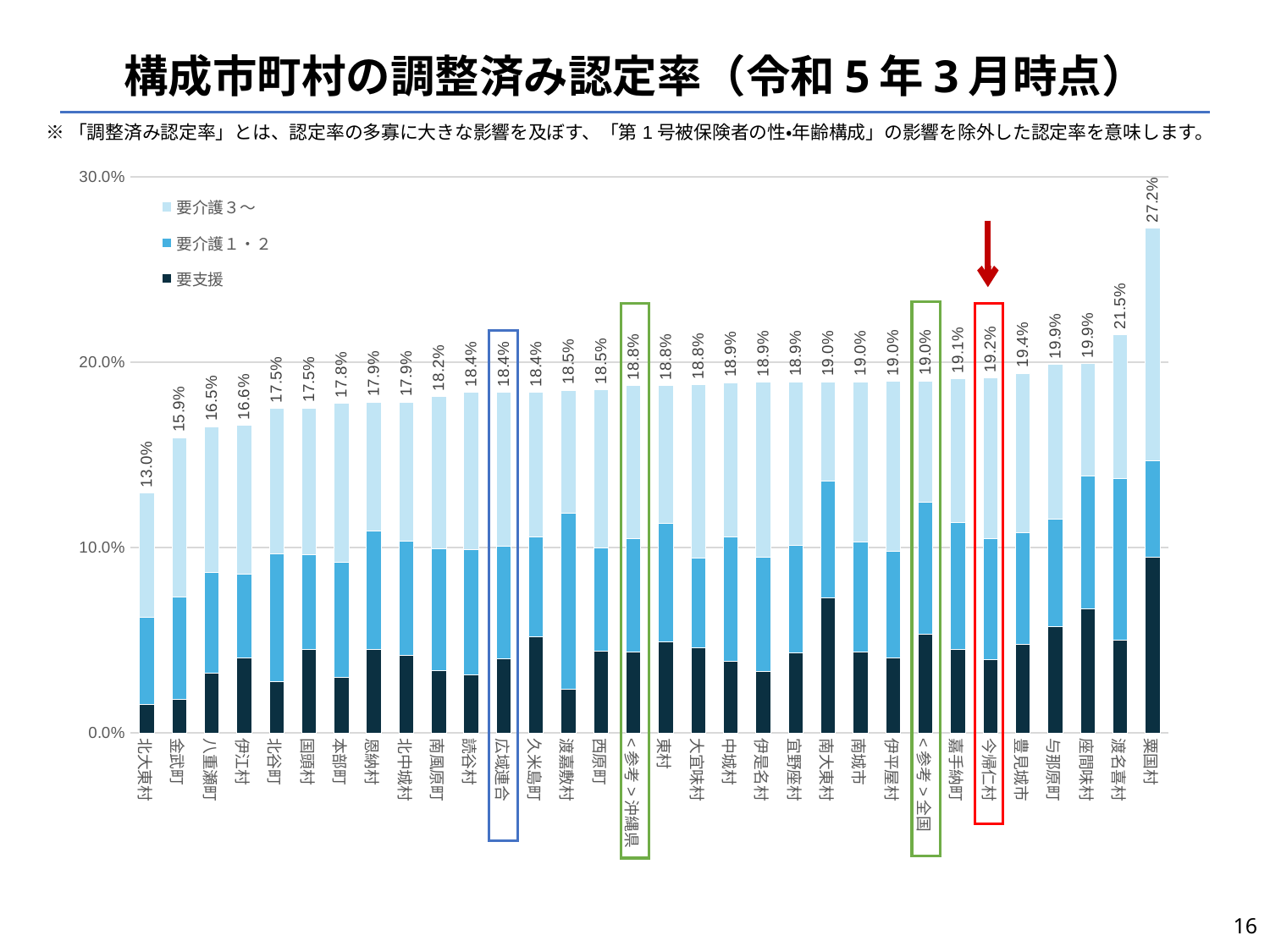
Which municipality has the lowest total adjusted certification rate? 北大東村 What is the total adjusted certification rate (調整済み認定率) shown for 粟国村? 27.2% Which municipality has the highest total adjusted certification rate? 粟国村 What is the difference between the total rate for <参考>全国 and the total rate for <参考>沖縄県? 0.2% Is the total value for 金武町 greater or less than 20.0%? less How many municipalities or reference categories are shown on the x axis? 32 How many series does the legend list? 3 What is the total value labeled for 今帰仁村, the bar highlighted with the red box and arrow? 19.2% What is the total value labeled for 広域連合? 18.4% Which has a higher total rate, 渡名喜村 or 豊見城市? 渡名喜村 What is the difference between the total rate for 粟国村 and the total rate for 北大東村? 14.2% What kind of chart is shown on the slide? Stacked bar chart